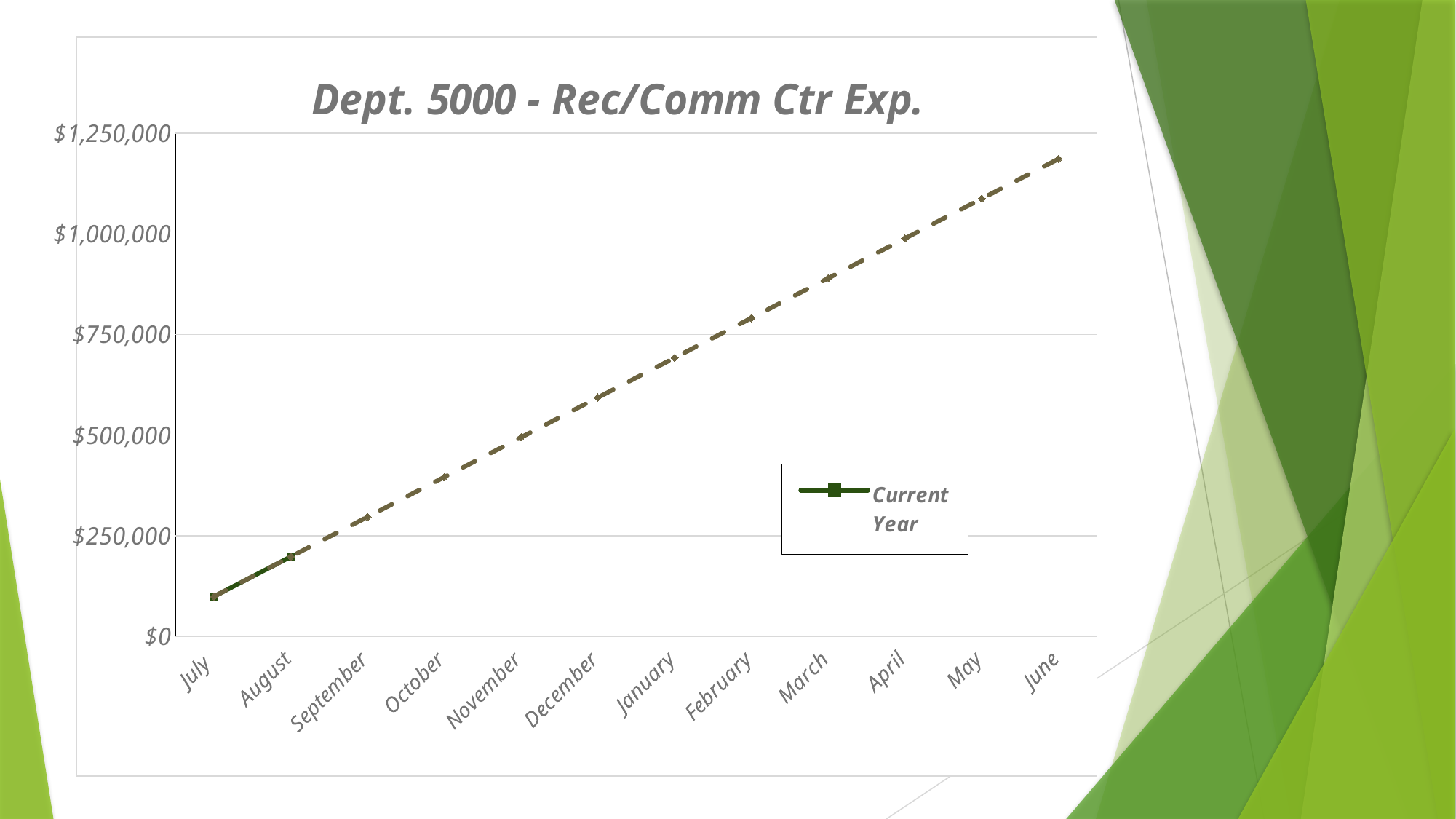
Do the values rise or fall from July to June? rise Which month has the highest value? June Which is larger, the value for August or the value for July? August What series name appears in the legend? Current Year What is the title of the chart? Dept. 5000 - Rec/Comm Ctr Exp. How many series does the legend list? 1 What kind of chart is shown on the slide? line chart How many months are shown on the x axis of the chart? 12 Is the value for June greater or less than $1,000,000? greater Is the value for December greater or less than $500,000? greater Which month has the lowest value? July Is the value for July greater or less than $250,000? less